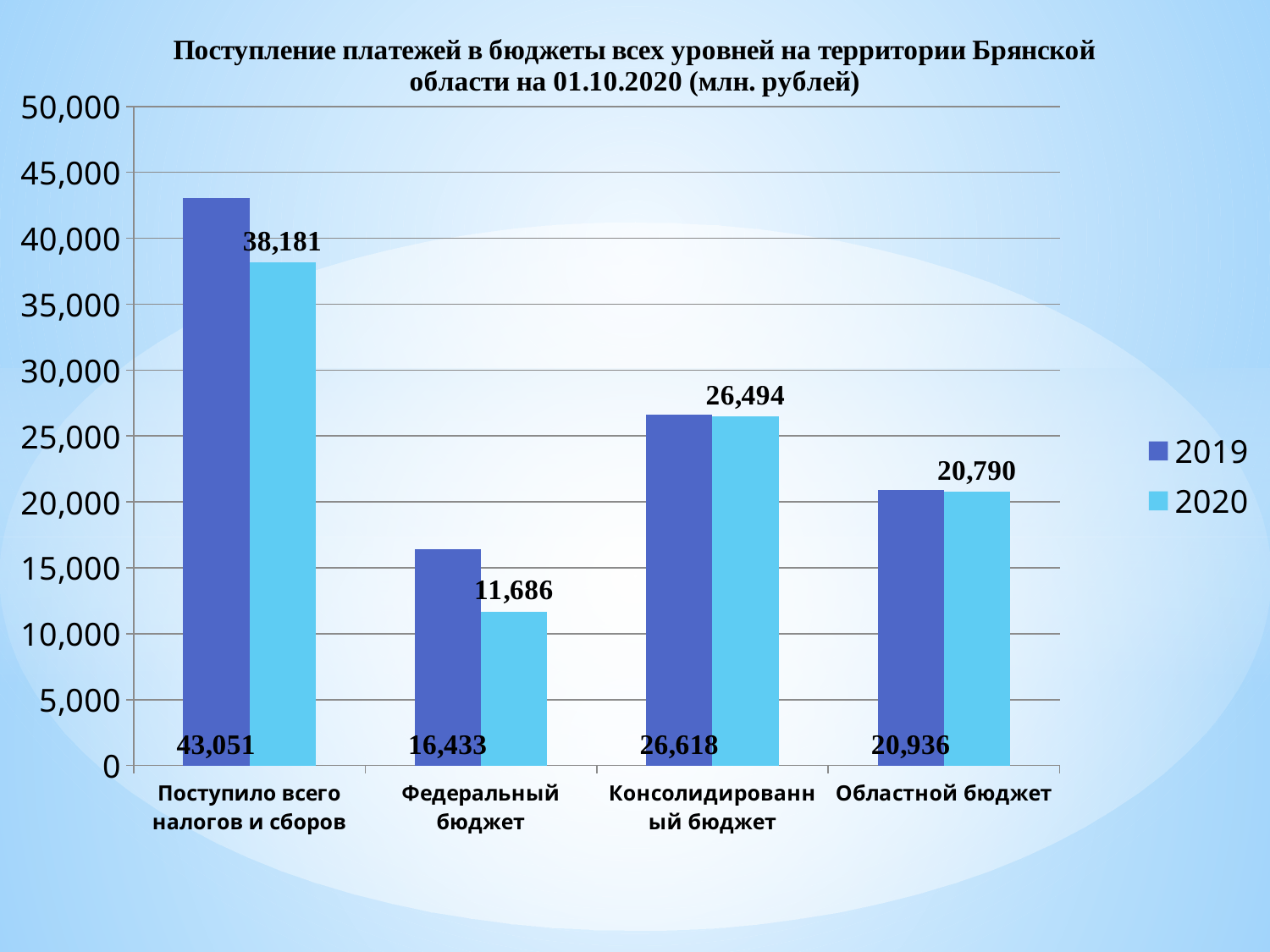
How many series does the legend list? 2 What is the 2019 value for Областной бюджет? 20,936 Which category has the lowest 2020 value? Федеральный бюджет What is the difference between the 2019 and 2020 values for Федеральный бюджет? 4,747 Which category has the highest 2019 value? Поступило всего налогов и сборов How many categories are shown on the x axis? 4 What is the 2019 value for Федеральный бюджет? 16,433 What is the 2020 value for Консолидированный бюджет? 26,494 Which is larger: the 2019 value for Консолидированный бюджет or the 2019 value for Областной бюджет? Консолидированный бюджет What is the 2020 value for Поступило всего налогов и сборов? 38,181 What is the difference between the 2019 and 2020 values for Поступило всего налогов и сборов? 4,870 What kind of chart is shown on the slide? Bar chart